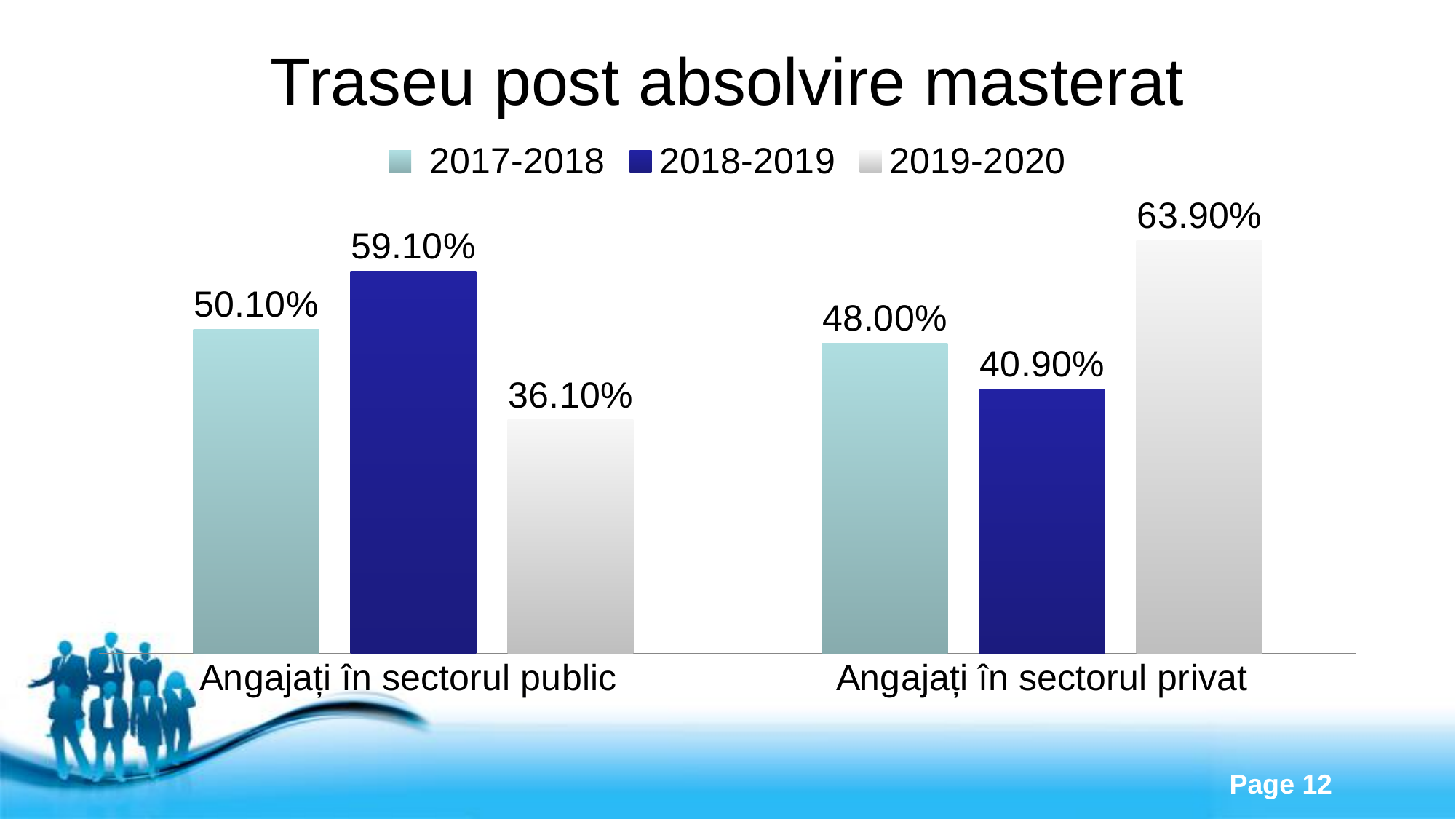
What is the value for 2018-2019 in the 'Angajați în sectorul privat' category? 40.90% What is the value for 2017-2018 in the 'Angajați în sectorul public' category? 50.10% Which is larger: the 2017-2018 value for 'Angajați în sectorul public' or the 2017-2018 value for 'Angajați în sectorul privat'? Angajați în sectorul public Which series has the lowest value in the 'Angajați în sectorul privat' category? 2018-2019 What is the value for 2019-2020 in the 'Angajați în sectorul privat' category? 63.90% What is the title of the slide? Traseu post absolvire masterat What kind of chart is shown on the slide? Bar chart How many categories are shown on the x axis? 2 Which series has the highest value in the 'Angajați în sectorul public' category? 2018-2019 What is the difference between the 2019-2020 and 2017-2018 values for 'Angajați în sectorul privat'? 15.90% What is the difference between the 2018-2019 and 2019-2020 values for 'Angajați în sectorul public'? 23.00% How many series does the legend list? 3